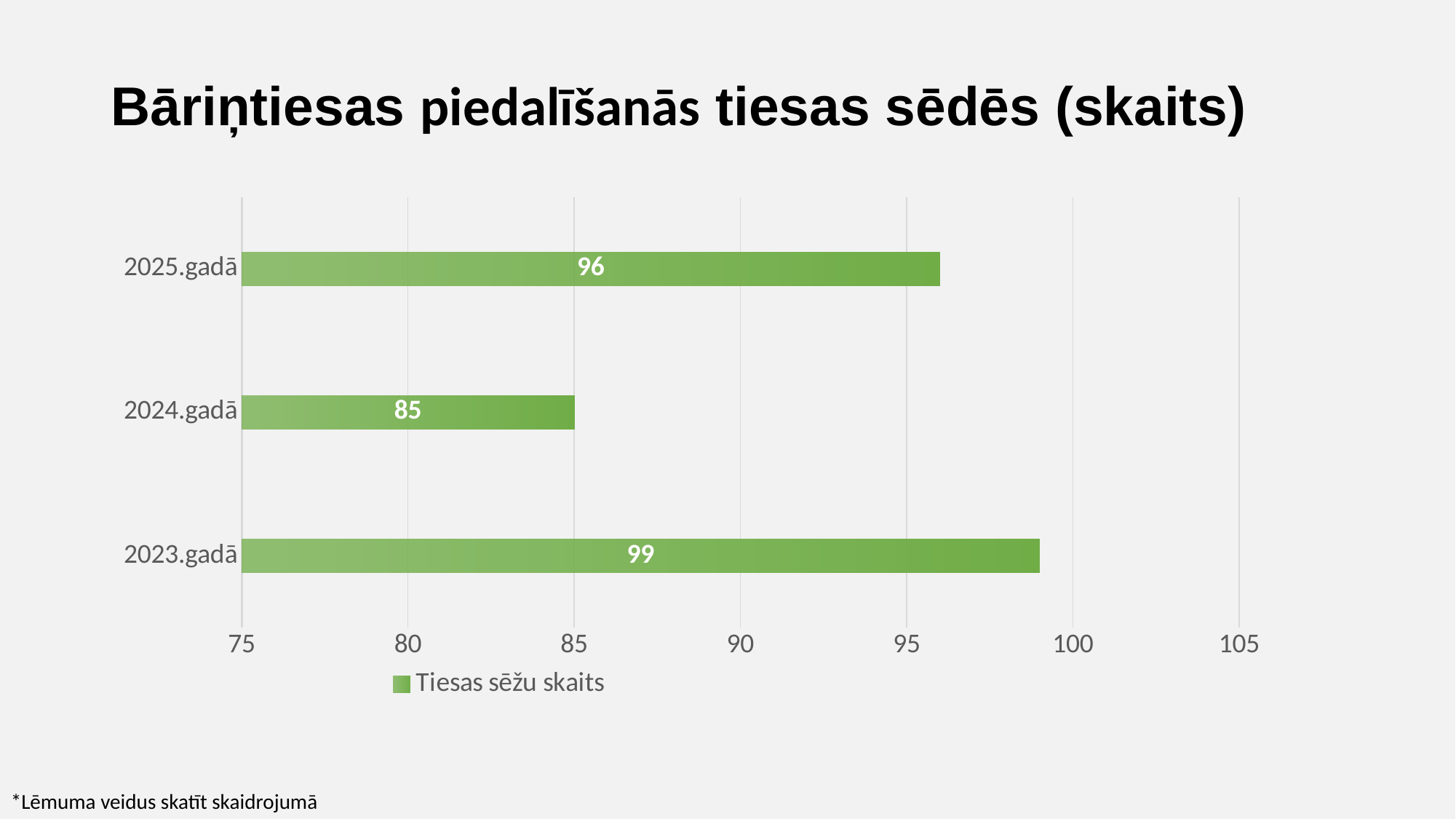
What is the difference between the values for 2023.gadā and 2024.gadā? 14 Which year has the highest number of court sessions? 2023.gadā Which year has the lowest number of court sessions? 2024.gadā What kind of chart is shown on the slide? bar chart Which is larger, the value for 2025.gadā or the value for 2023.gadā? 2023.gadā What is the value for 2025.gadā? 96 What is the value for 2023.gadā? 99 How many categories (years) are shown in the chart? 3 What is the difference between the values for 2025.gadā and 2024.gadā? 11 Is the value for 2024.gadā greater or less than 90? less What is the legend entry for the series in the chart? Tiesas sēžu skaits What is the value for 2024.gadā? 85